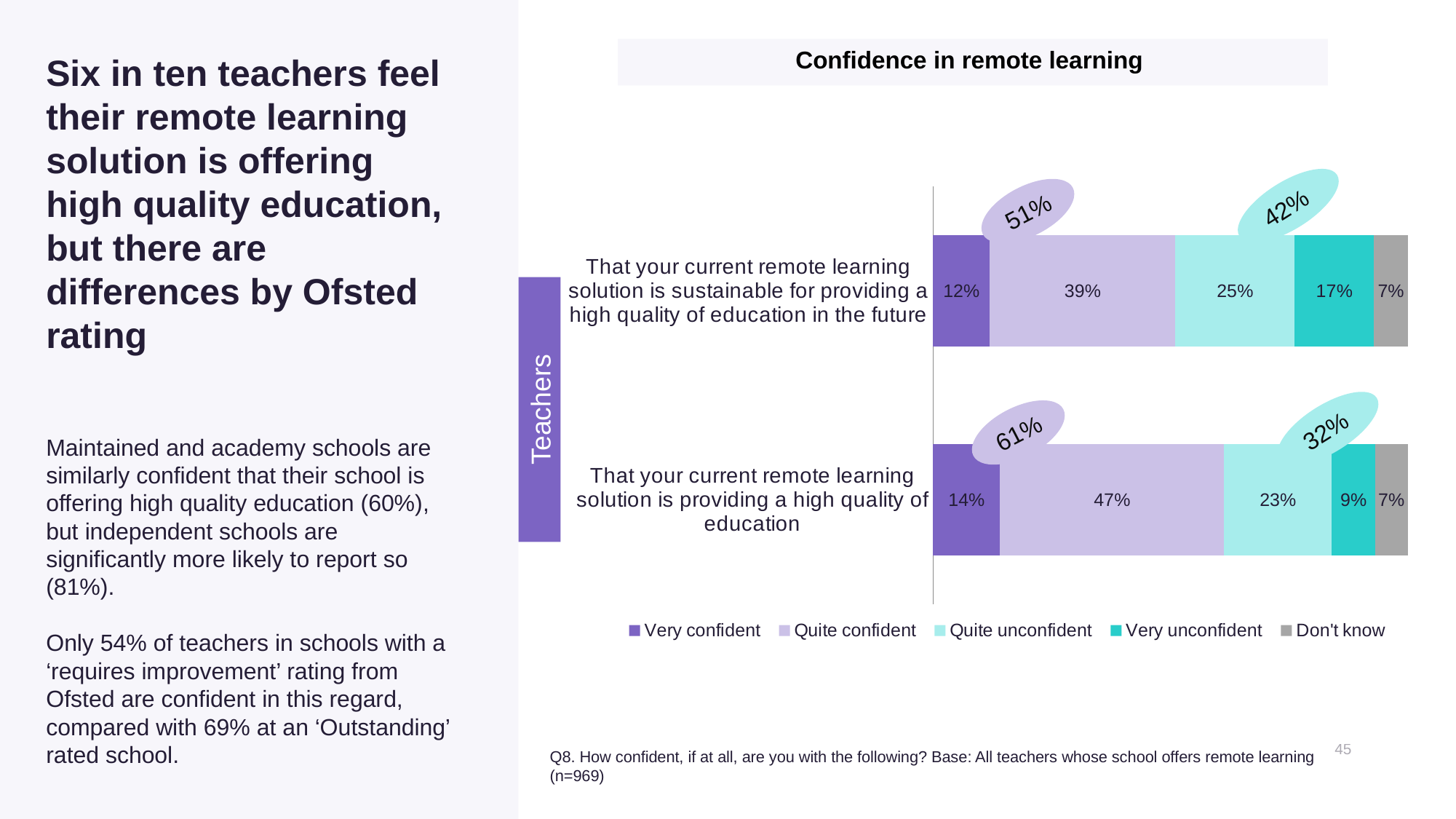
What percentage of teachers are 'Quite confident' that their current remote learning solution is sustainable for providing a high quality of education in the future? 39% What is the difference between the 'Quite confident' values for the two statements? 8% What percentage of teachers are 'Very confident' that their current remote learning solution is providing a high quality of education? 14% What is the title of the chart? Confidence in remote learning Which response category has the highest value for the statement that the current remote learning solution is providing a high quality of education? Quite confident What type of chart is shown on the slide? Stacked bar chart What percentage of teachers are 'Very unconfident' that their current remote learning solution is sustainable for providing a high quality of education in the future? 17% Which response category has the lowest value for the statement that the current remote learning solution is sustainable for providing a high quality of education in the future? Don't know How many series does the chart legend list? 5 How many statements (bars) are shown in the chart? 2 Which statement has the larger 'Very unconfident' value: sustainable for the future, or providing a high quality of education? Sustainable for providing a high quality of education in the future What is the 'Don't know' value for the statement that the current remote learning solution is providing a high quality of education? 7%